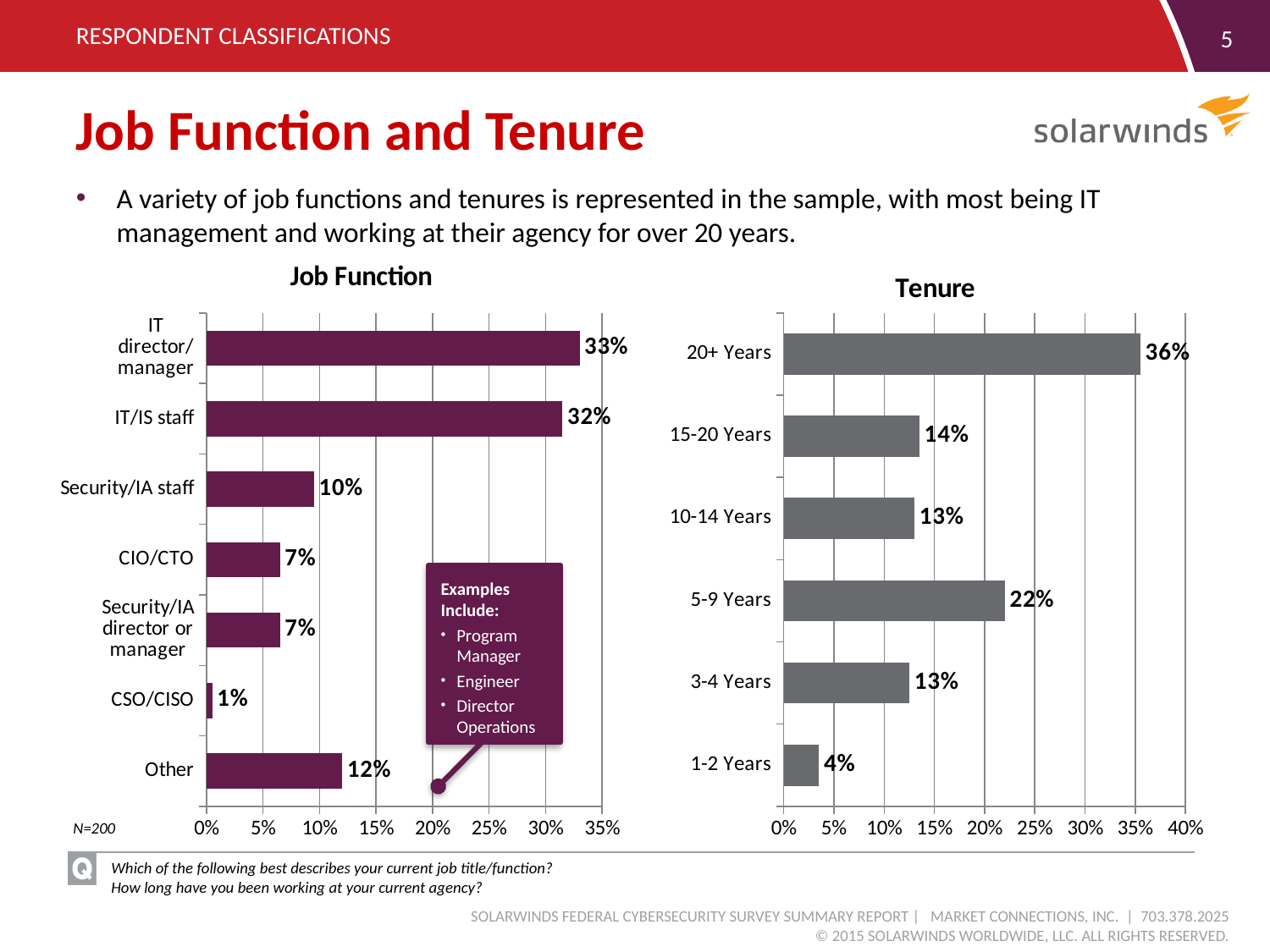
In the Job Function chart, which category has the lowest value? CSO/CISO In the Job Function chart, how many job function categories are shown? 7 In the Tenure chart, what percentage of respondents have 20+ Years of tenure? 36% In the Tenure chart, how many tenure categories are shown? 6 In the Tenure chart, which tenure category has the lowest value? 1-2 Years What type of chart is the Tenure chart? Bar chart In the Tenure chart, which tenure category has the highest value? 20+ Years In the Job Function chart, which is larger: Security/IA staff or CIO/CTO? Security/IA staff In the Tenure chart, what is the difference between 5-9 Years and 15-20 Years? 8% In the Job Function chart, what percentage of respondents are IT director/manager? 33% In the Job Function chart, what is the value for Security/IA staff? 10% In the Job Function chart, what is the difference between IT/IS staff and Other? 20%